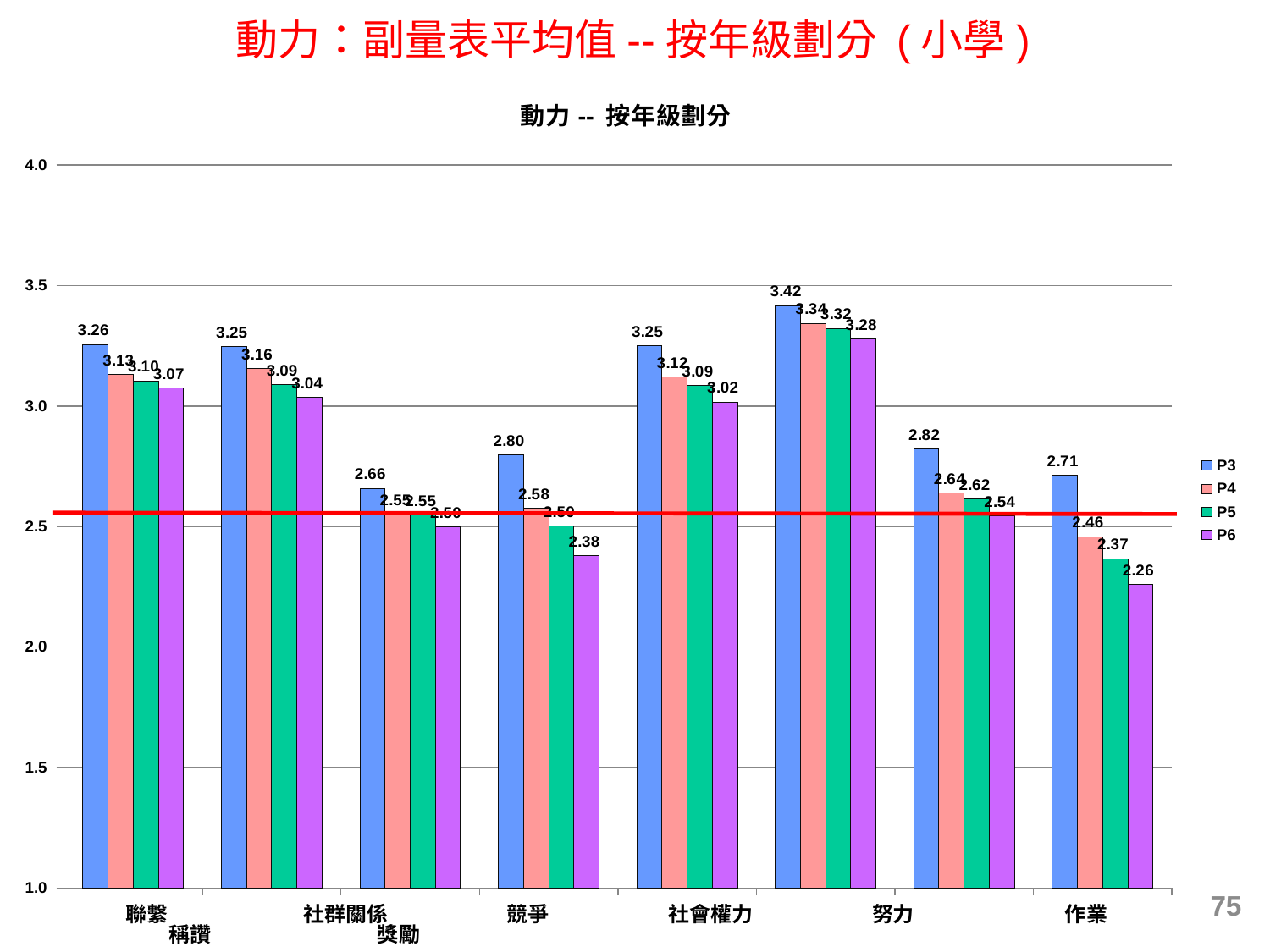
Within the 社會權力 category, do the values rise or fall from P3 to P6? fall Which is larger, the P5 value for 聯繫 or the P5 value for 稱讚? P5 value for 聯繫 What is the title of the chart? 動力 -- 按年級劃分 How many series does the legend list? 4 How many categories are shown on the x axis? 8 What type of chart is shown on the slide? bar chart